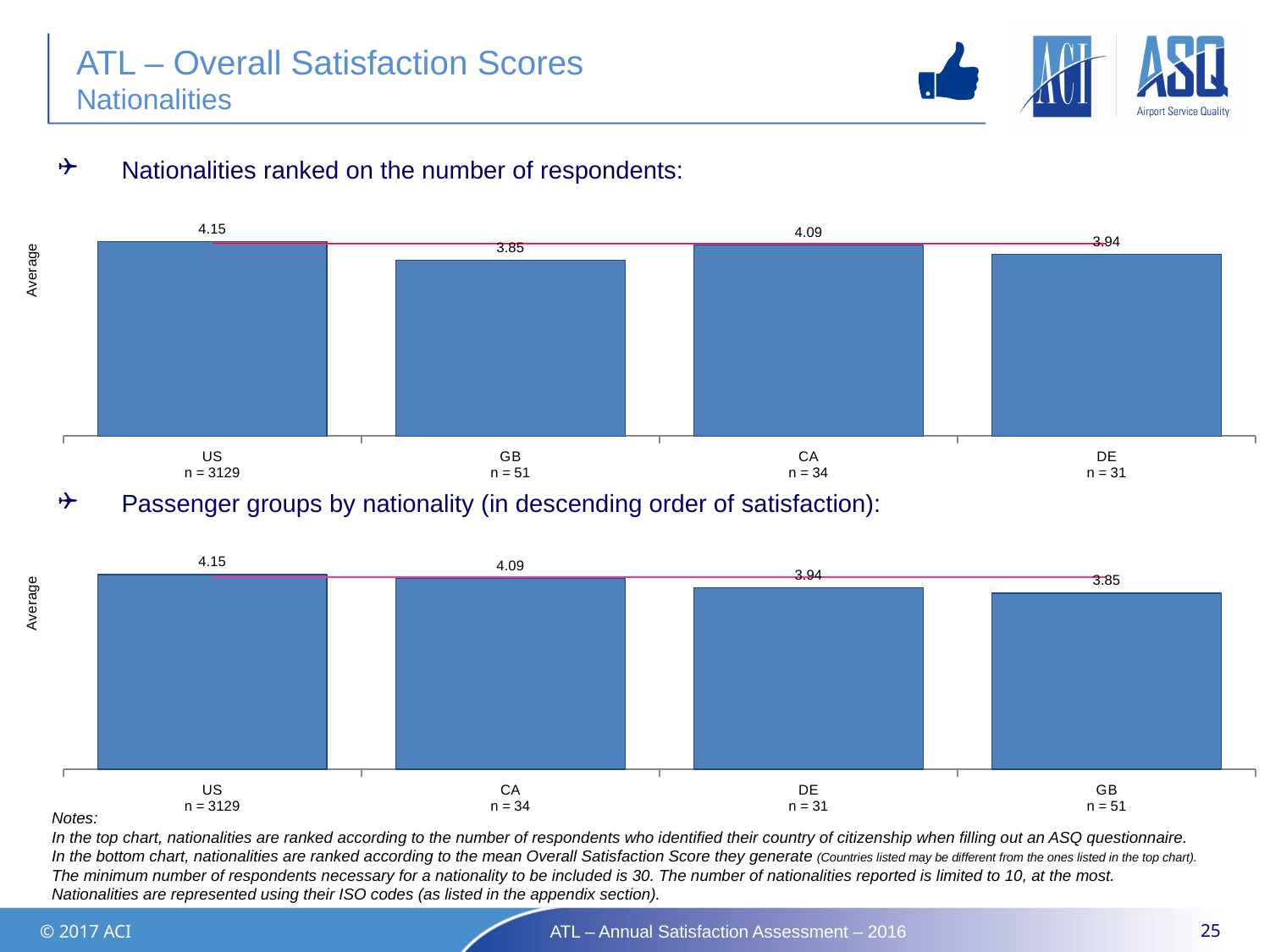
In the top chart (nationalities ranked on the number of respondents), what is the average score for US? 4.15 In the top chart (nationalities ranked on the number of respondents), what is the average score for CA? 4.09 In the bottom chart (passenger groups by nationality in descending order of satisfaction), what is the difference between the average scores for CA and DE? 0.15 In the top chart (nationalities ranked on the number of respondents), which has the higher average score, CA or DE? CA In the top chart (nationalities ranked on the number of respondents), what is the average score for GB? 3.85 In the bottom chart (passenger groups by nationality in descending order of satisfaction), what is the average score for DE? 3.94 In the bottom chart (passenger groups by nationality in descending order of satisfaction), which nationality has the lowest average score? GB In the top chart (nationalities ranked on the number of respondents), which nationality has the highest average score? US How many nationalities are shown in the bottom chart (passenger groups by nationality in descending order of satisfaction)? 4 In the top chart (nationalities ranked on the number of respondents), what is the difference between the average scores for US and GB? 0.30 What kind of chart is the top chart (nationalities ranked on the number of respondents)? Bar chart In the top chart (nationalities ranked on the number of respondents), how many respondents does the US group have (n)? n = 3129